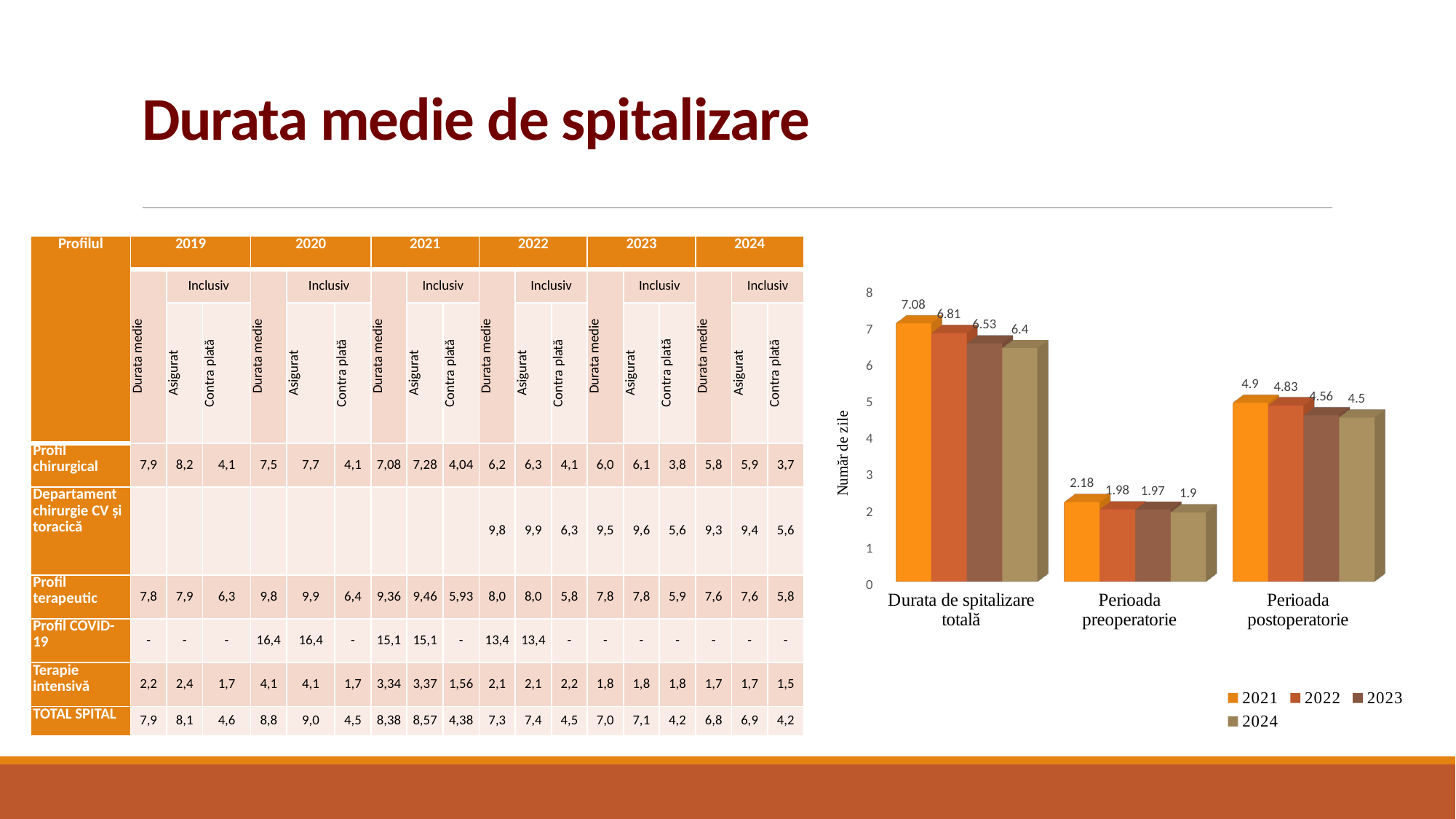
In the chart, which year has the highest value for Durata de spitalizare totală? 2021 How many categories are shown on the x axis of the chart? 3 In the chart, what is the value for 2024 for Perioada preoperatorie? 1.9 In the chart, which is larger: the 2022 value for Perioada preoperatorie or the 2022 value for Perioada postoperatorie? Perioada postoperatorie In the chart, which year has the lowest value for Perioada postoperatorie? 2024 In the chart, do the values for Perioada preoperatorie rise or fall from 2021 to 2024? fall In the chart, what is the value for 2023 for Perioada postoperatorie? 4.56 How many series does the chart's legend list? 4 What kind of chart is shown on the right of the slide? bar chart In the chart, what is the value for 2021 for Durata de spitalizare totală? 7.08 In the chart, what is the difference between the 2021 and 2024 values for Durata de spitalizare totală? 0.68 What is the label of the vertical axis of the chart? Număr de zile